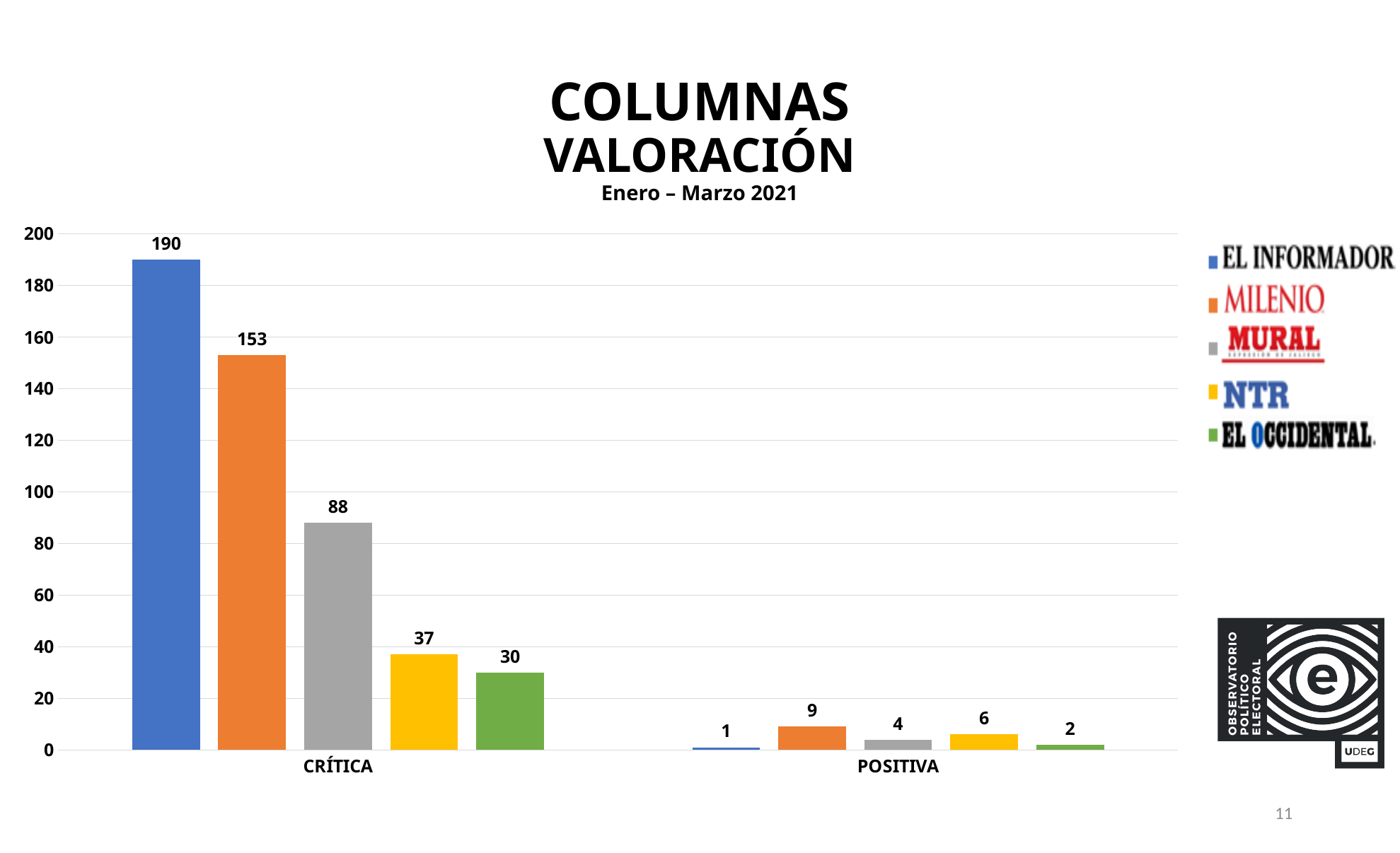
What is the value for NTR in the Crítica category? 37 What is the value for Milenio in the Positiva category? 9 Which newspaper has the highest value in the Crítica category? El Informador What kind of chart is shown on the slide? bar chart What is the value for El Informador in the Crítica category? 190 How many series does the legend list? 5 How many categories are shown on the x axis? 2 What is the difference between El Informador and Milenio in the Crítica category? 37 What period does the chart subtitle cover? Enero – Marzo 2021 Is the value for Mural in the Crítica category greater or less than 100? less Which is larger in the Crítica category, Mural or El Occidental? Mural Which newspaper has the lowest value in the Positiva category? El Informador